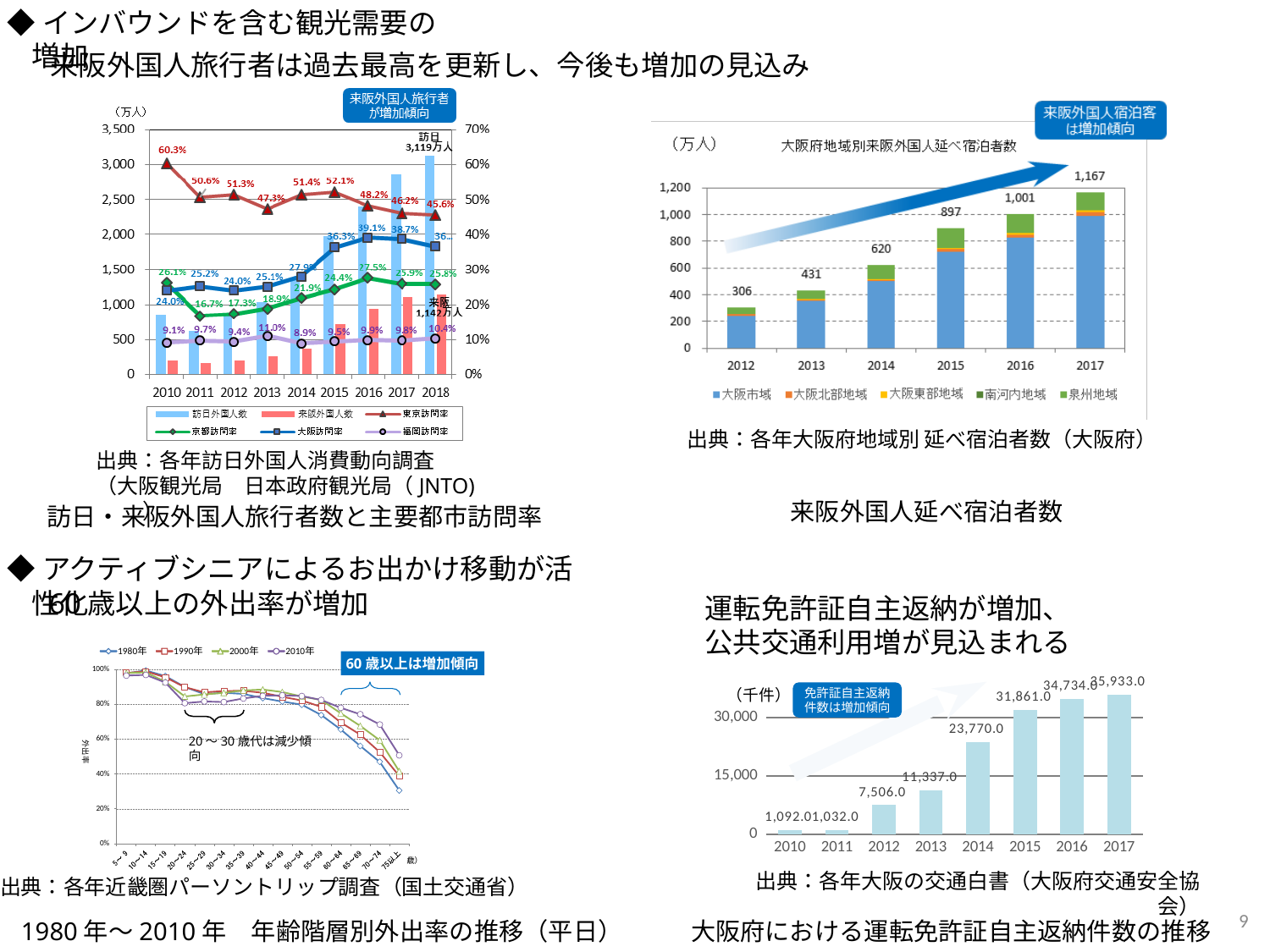
In the chart titled 大阪府における運転免許証自主返納件数の推移 (bottom right), how many years are plotted? 8 In the chart titled 大阪府における運転免許証自主返納件数の推移 (bottom right), which year has the highest value? 2017 In the chart titled 訪日・来阪外国人旅行者数と主要都市訪問率 (top left), what is the 東京訪問率 value for 2010? 60.3% In the chart titled 大阪府地域別来阪外国人延べ宿泊者数 (top right), what is the difference between the 2017 total and the 2016 total? 166 In the chart titled 大阪府地域別来阪外国人延べ宿泊者数 (top right), what is the total value shown for 2017? 1,167 In the chart titled 大阪府における運転免許証自主返納件数の推移 (bottom right), what is the value for 2014? 23,770.0 In the chart titled 訪日・来阪外国人旅行者数と主要都市訪問率 (top left), which is larger in 2016, the 大阪訪問率 or the 京都訪問率? 大阪訪問率 In the chart titled 年齢階層別外出率の推移 (bottom left), how many series does the legend list? 4 In the chart titled 大阪府における運転免許証自主返納件数の推移 (bottom right), what kind of chart is it? bar chart In the chart titled 大阪府地域別来阪外国人延べ宿泊者数 (top right), do the totals rise or fall from 2012 to 2017? rise In the chart titled 大阪府地域別来阪外国人延べ宿泊者数 (top right), which year has the lowest total? 2012 In the chart titled 大阪府地域別来阪外国人延べ宿泊者数 (top right), how many series does the legend list? 5